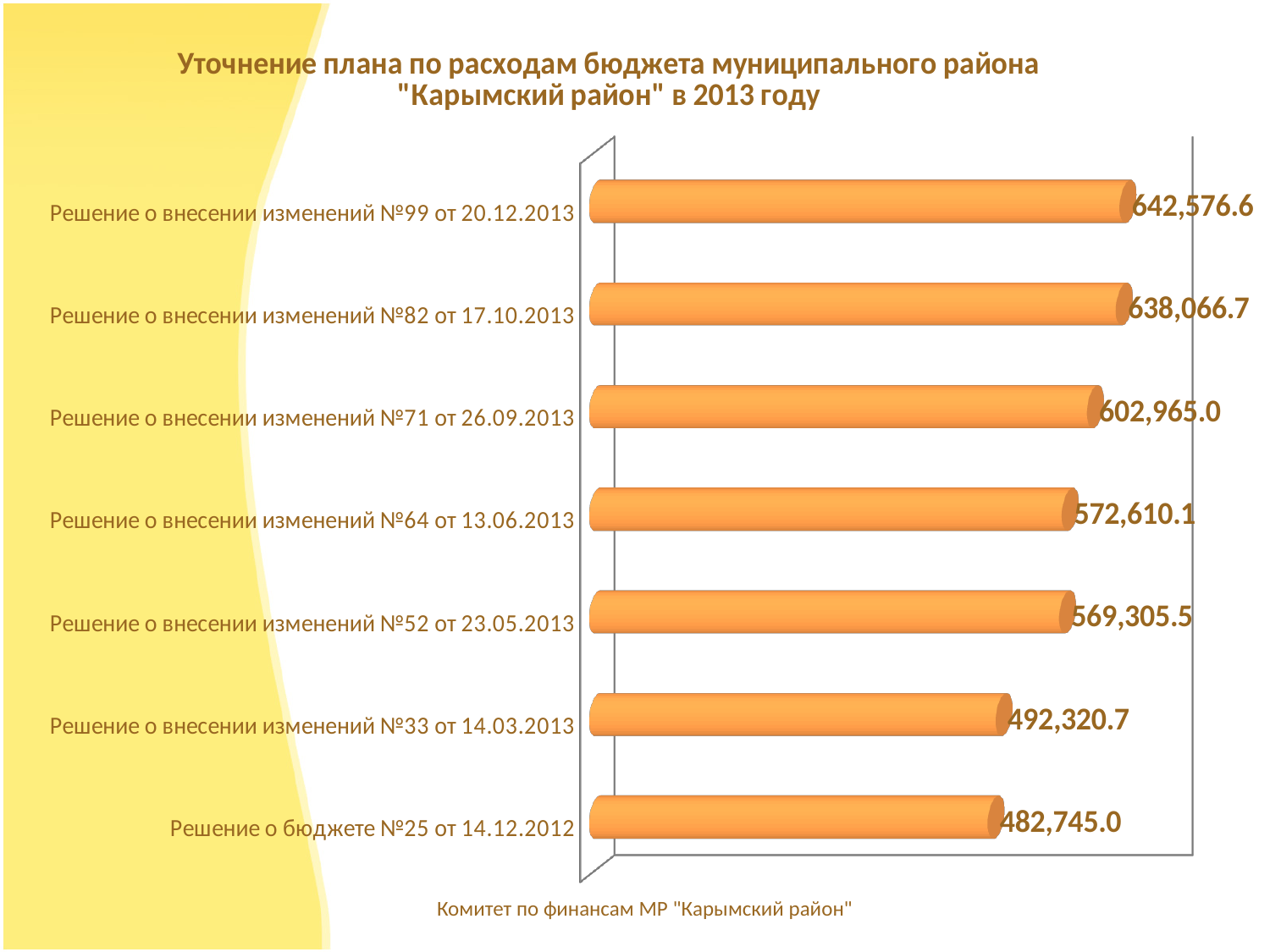
What type of chart is shown on the slide? bar chart What is the value for "Решение о бюджете №25 от 14.12.2012"? 482,745.0 How many bars (categories) does the chart show? 7 Which category has the lowest value? Решение о бюджете №25 от 14.12.2012 Which is larger: the value for "Решение о внесении изменений №71 от 26.09.2013" or the value for "Решение о внесении изменений №33 от 14.03.2013"? Решение о внесении изменений №71 от 26.09.2013 Which category has the highest value? Решение о внесении изменений №99 от 20.12.2013 What is the title of the chart? Уточнение плана по расходам бюджета муниципального района "Карымский район" в 2013 году What is the value for "Решение о внесении изменений №64 от 13.06.2013"? 572,610.1 What is the difference between the value for "Решение о внесении изменений №99 от 20.12.2013" and the value for "Решение о бюджете №25 от 14.12.2012"? 159,831.6 What is the difference between the value for "Решение о внесении изменений №71 от 26.09.2013" and the value for "Решение о внесении изменений №64 от 13.06.2013"? 30,354.9 What is the value for "Решение о внесении изменений №99 от 20.12.2013"? 642,576.6 What is the value for "Решение о внесении изменений №33 от 14.03.2013"? 492,320.7